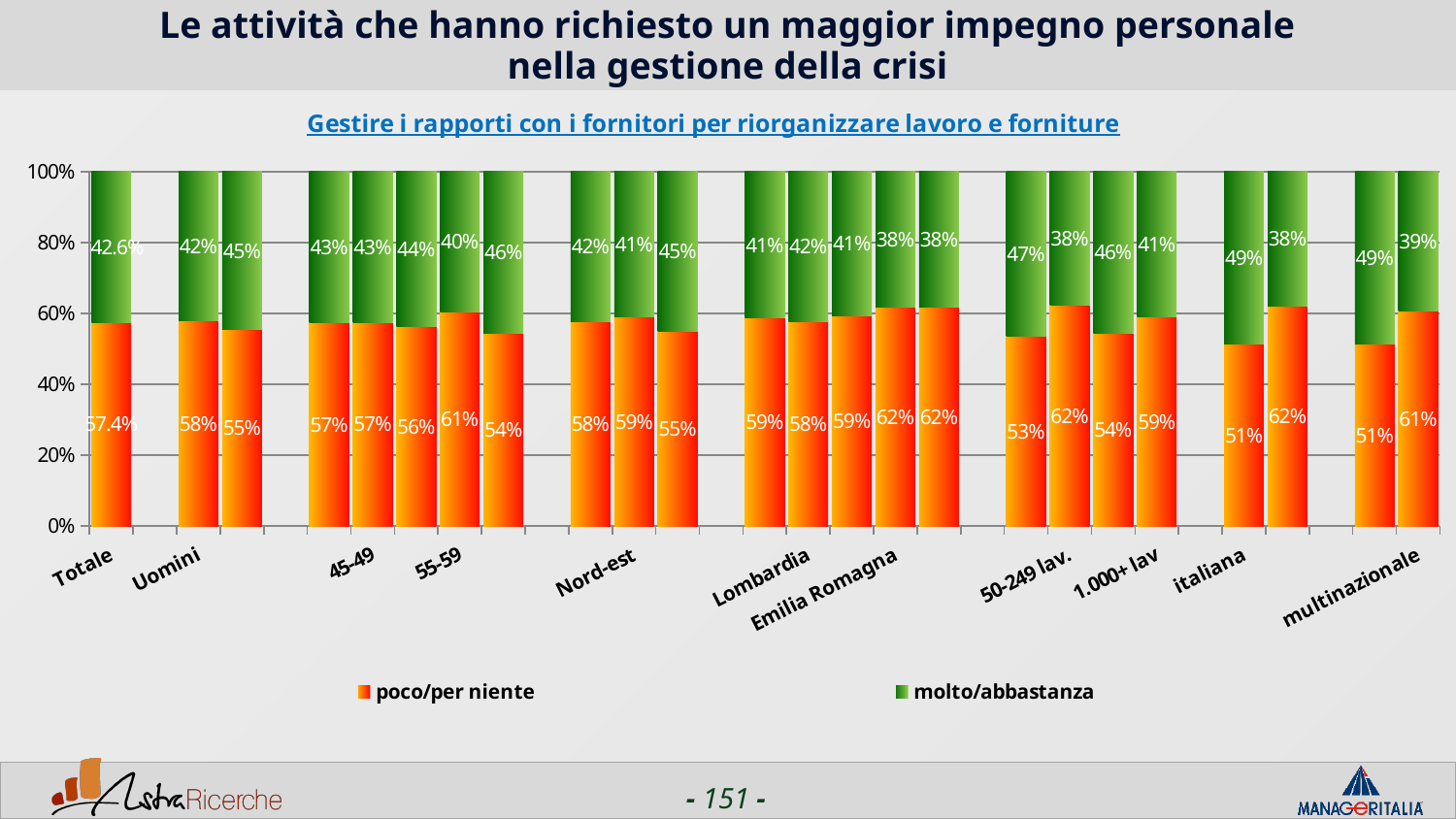
What is the 'poco/per niente' value for Uomini? 58% What is the 'poco/per niente' value for Totale? 57.4% What is the total of the stacked bar for Totale? 100% What is the 'molto/abbastanza' value for italiana? 49% How many series does the legend list? 2 What is the 'molto/abbastanza' value for multinazionale? 39% What kind of chart is shown on the slide? stacked bar chart Which is larger for Uomini: 'poco/per niente' or 'molto/abbastanza'? poco/per niente What is the difference between the 'poco/per niente' values for multinazionale and italiana? 10% Which legend entry is shown in orange? poco/per niente What is the 'molto/abbastanza' value for Totale? 42.6% What is the 'poco/per niente' value for multinazionale? 61%